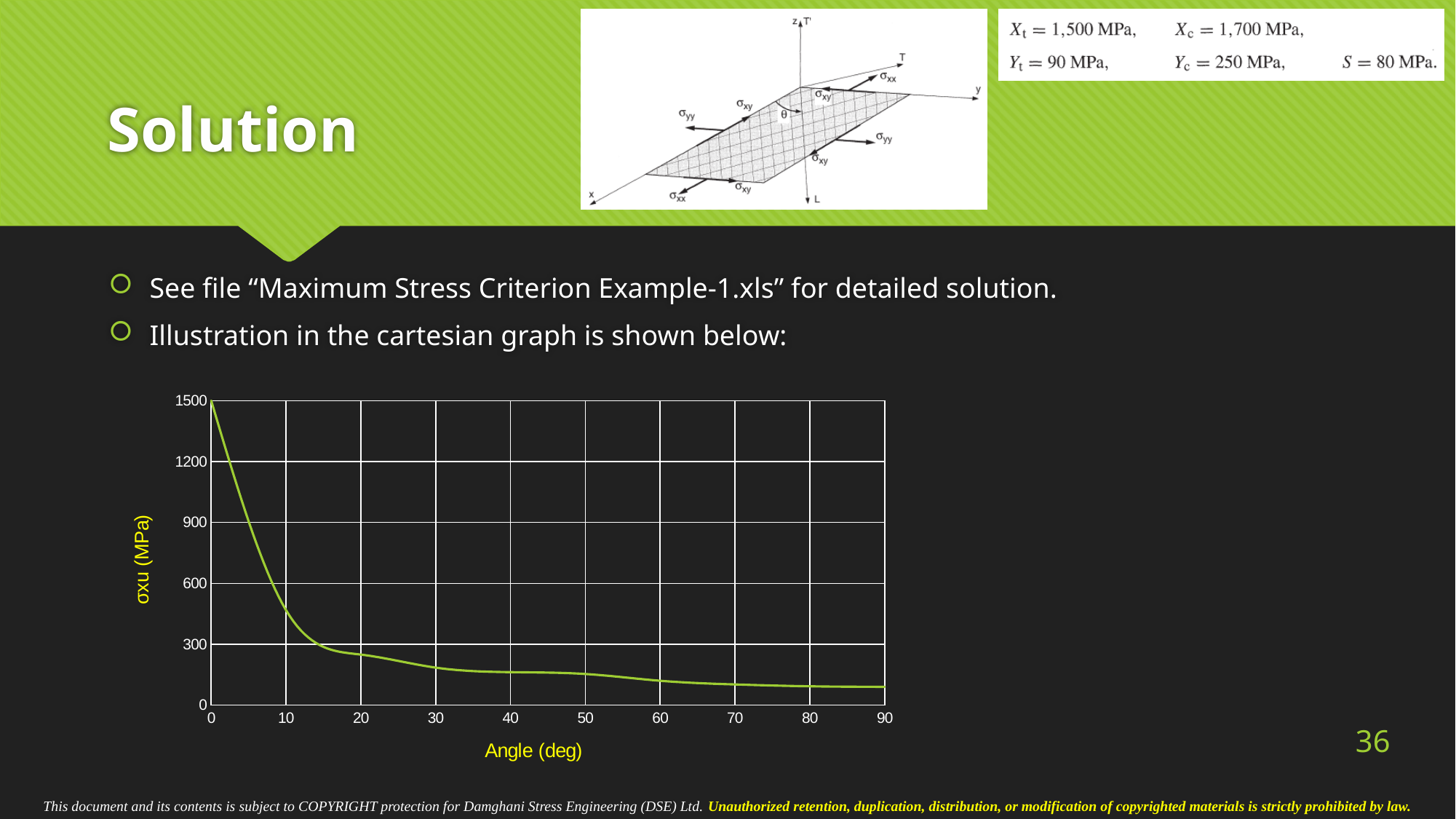
Is the value of σxu at 10 degrees greater or less than 300? greater At which angle is σxu highest? 0 At which angle is σxu lowest? 90 What is the value of σxu at an angle of 0 degrees? 1500 Is the value of σxu at 10 degrees greater or less than 600? less What kind of chart is shown on the slide? line chart Does the value of σxu rise or fall as the angle increases from 0 to 90 degrees? fall What is the label of the x axis of the chart? Angle (deg) Is the value of σxu at 90 degrees greater or less than 300? less Which is larger, σxu at 10 degrees or σxu at 40 degrees? 10 degrees What is the label of the y axis of the chart? σxu (MPa)